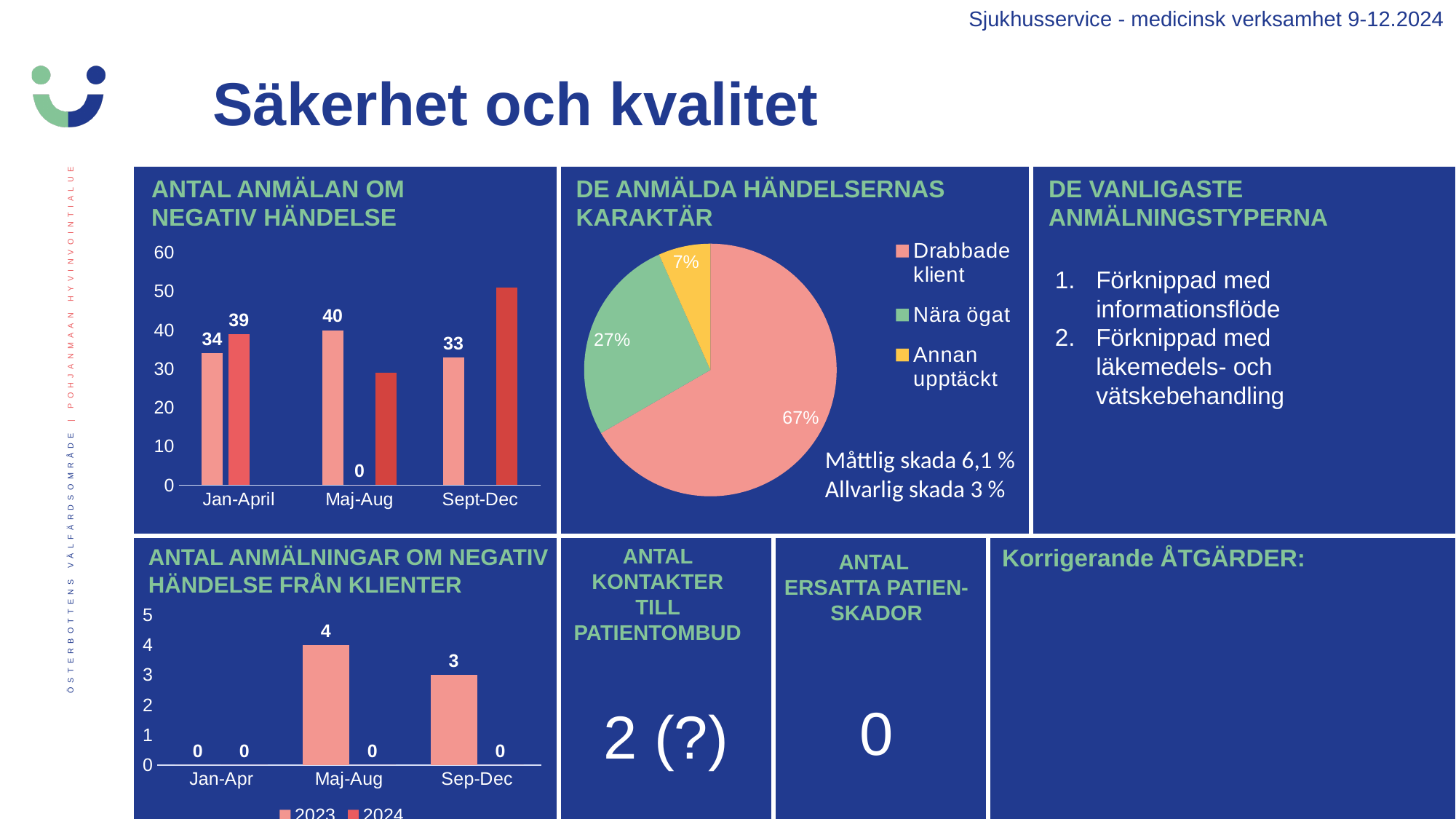
In the chart 'ANTAL ANMÄLNINGAR OM NEGATIV HÄNDELSE FRÅN KLIENTER', how many series does the legend list? 2 In the chart 'ANTAL ANMÄLNINGAR OM NEGATIV HÄNDELSE FRÅN KLIENTER', what is the value for 2023 in Maj-Aug? 4 In the chart 'ANTAL ANMÄLNINGAR OM NEGATIV HÄNDELSE FRÅN KLIENTER', which is larger, the 2023 value for Maj-Aug or the 2023 value for Sep-Dec? Maj-Aug In the pie chart 'DE ANMÄLDA HÄNDELSERNAS KARAKTÄR', which category has the smallest slice? Annan upptäckt In the pie chart 'DE ANMÄLDA HÄNDELSERNAS KARAKTÄR', what is the difference between the shares of 'Nära ögat' and 'Annan upptäckt'? 20% In the chart 'ANTAL ANMÄLAN OM NEGATIV HÄNDELSE', how many categories are shown on the x axis? 3 In the chart 'ANTAL ANMÄLAN OM NEGATIV HÄNDELSE', what is the value of the red bar for Jan-April? 39 In the chart 'ANTAL ANMÄLAN OM NEGATIV HÄNDELSE', is the value of the red bar for Sept-Dec greater or less than 40? greater In the chart 'ANTAL ANMÄLAN OM NEGATIV HÄNDELSE', what is the value of the lighter pink bar for Maj-Aug? 40 In the pie chart 'DE ANMÄLDA HÄNDELSERNAS KARAKTÄR', what share does 'Drabbade klient' have? 67% In the chart 'ANTAL ANMÄLAN OM NEGATIV HÄNDELSE', what is the value of the lighter pink bar for Jan-April? 34 In the chart 'ANTAL ANMÄLAN OM NEGATIV HÄNDELSE', what is the difference between the lighter pink bars for Maj-Aug and Sept-Dec? 7